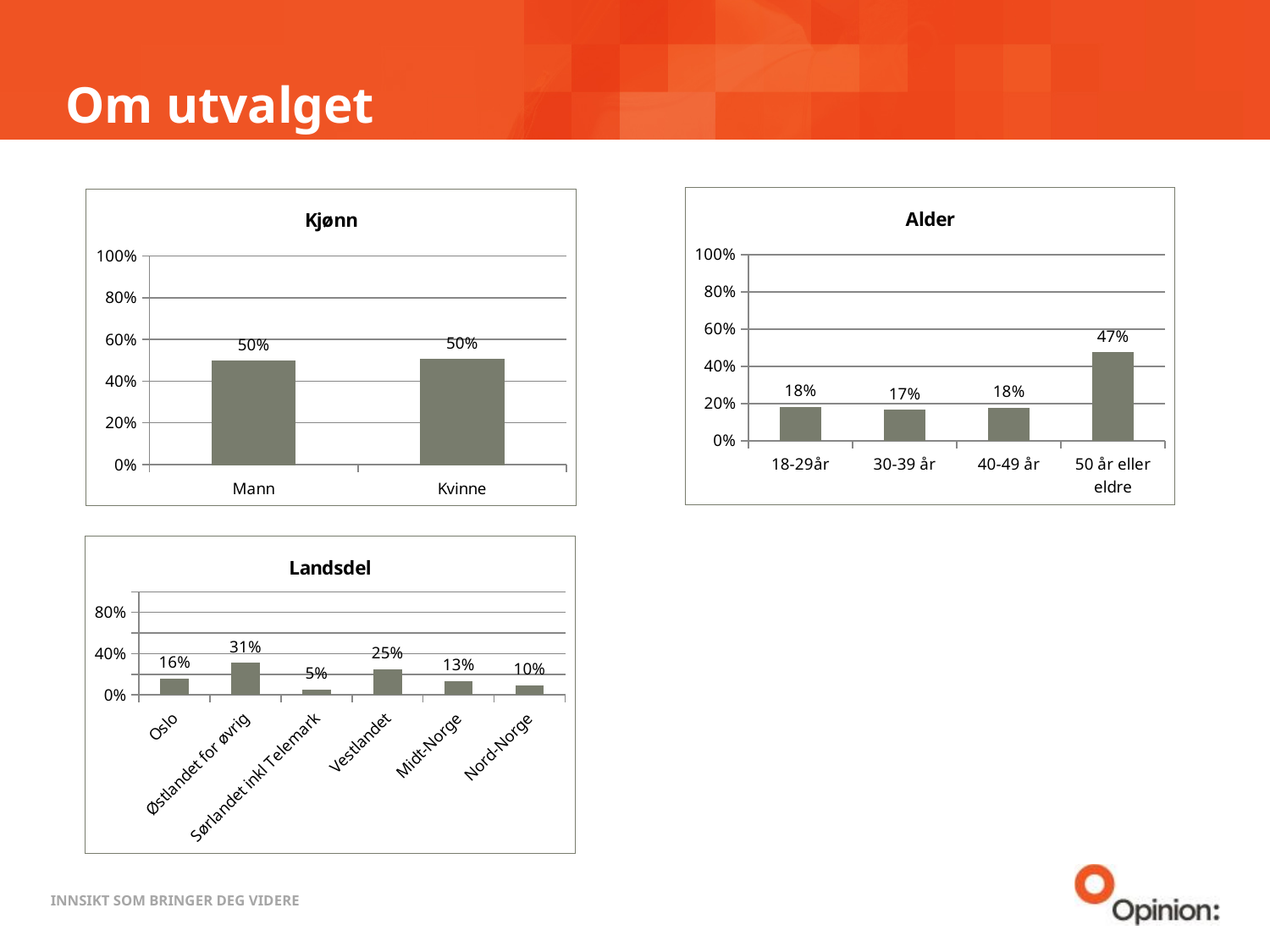
In the Landsdel chart, which category has the lowest value? Sørlandet inkl Telemark In the Landsdel chart, what is the value for Vestlandet? 25% What kind of chart is the Landsdel chart? Bar chart In the Alder chart, how many age categories are shown? 4 In the Kjønn chart, what is the value for Mann? 50% In the Landsdel chart, which is larger, Oslo or Midt-Norge? Oslo In the Alder chart, what is the value for 50 år eller eldre? 47% In the Landsdel chart, what is the difference between Østlandet for øvrig and Nord-Norge? 21% In the Alder chart, which category has the highest value? 50 år eller eldre In the Alder chart, what is the difference between 50 år eller eldre and 30-39 år? 30% In the Kjønn chart, how many categories are shown? 2 In the Landsdel chart, which category has the highest value? Østlandet for øvrig